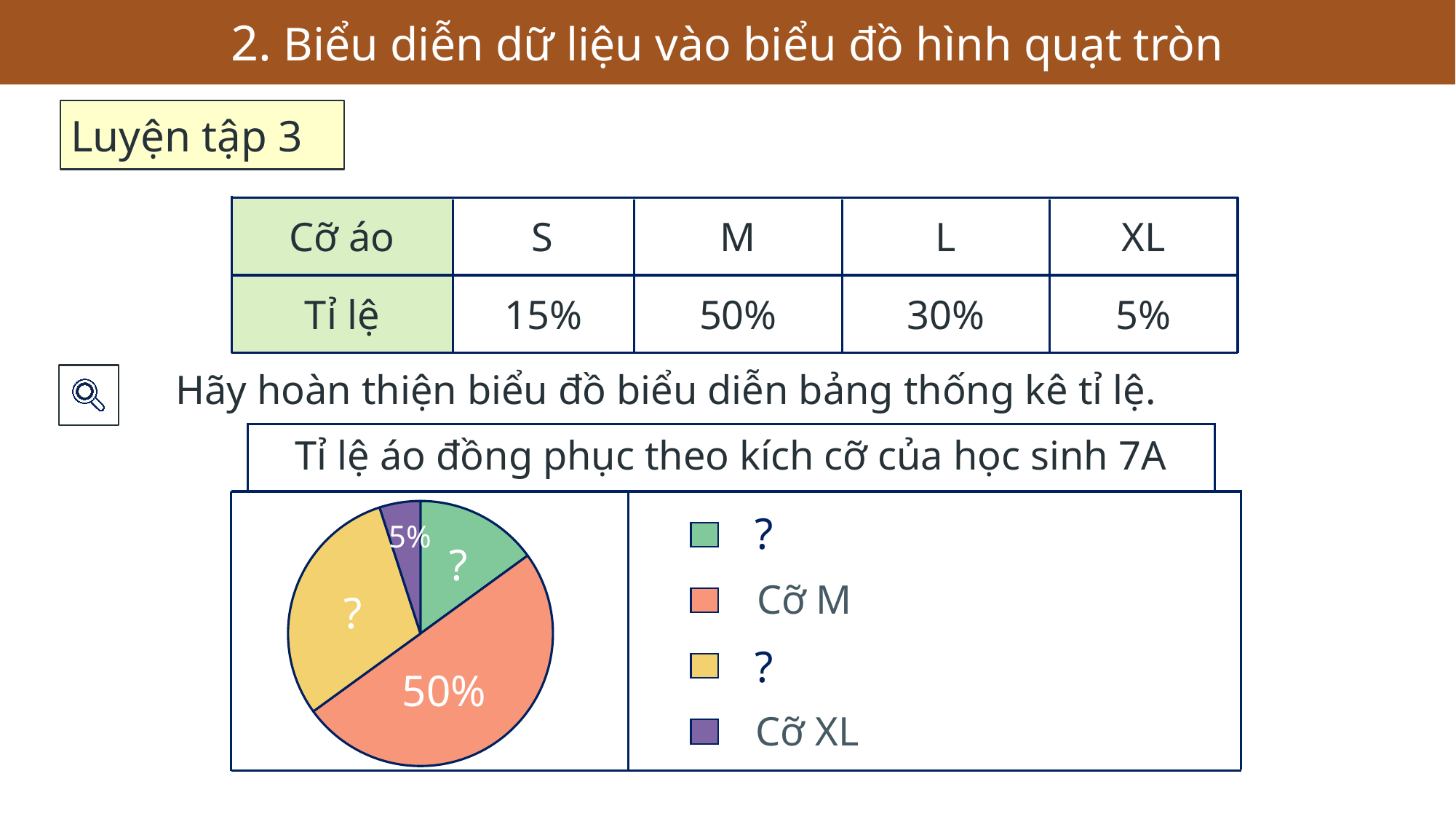
What kind of chart is shown on the slide? pie chart How many entries does the legend of the pie chart list? 4 What colour is the slice for Cỡ XL in the pie chart? purple How many slices does the pie chart have? 4 What percentage is shown for Cỡ XL in the pie chart? 5% Which legend entry corresponds to the largest slice of the pie chart? Cỡ M Which is larger in the pie chart, the slice for Cỡ M or the slice for Cỡ XL? Cỡ M What percentage is shown for Cỡ M in the pie chart? 50% What share of the pie does the Cỡ M slice represent? 50% What is the title of the pie chart? Tỉ lệ áo đồng phục theo kích cỡ của học sinh 7A Which legend entry corresponds to the smallest slice of the pie chart? Cỡ XL What is the difference between the percentages shown for Cỡ M and Cỡ XL in the pie chart? 45%